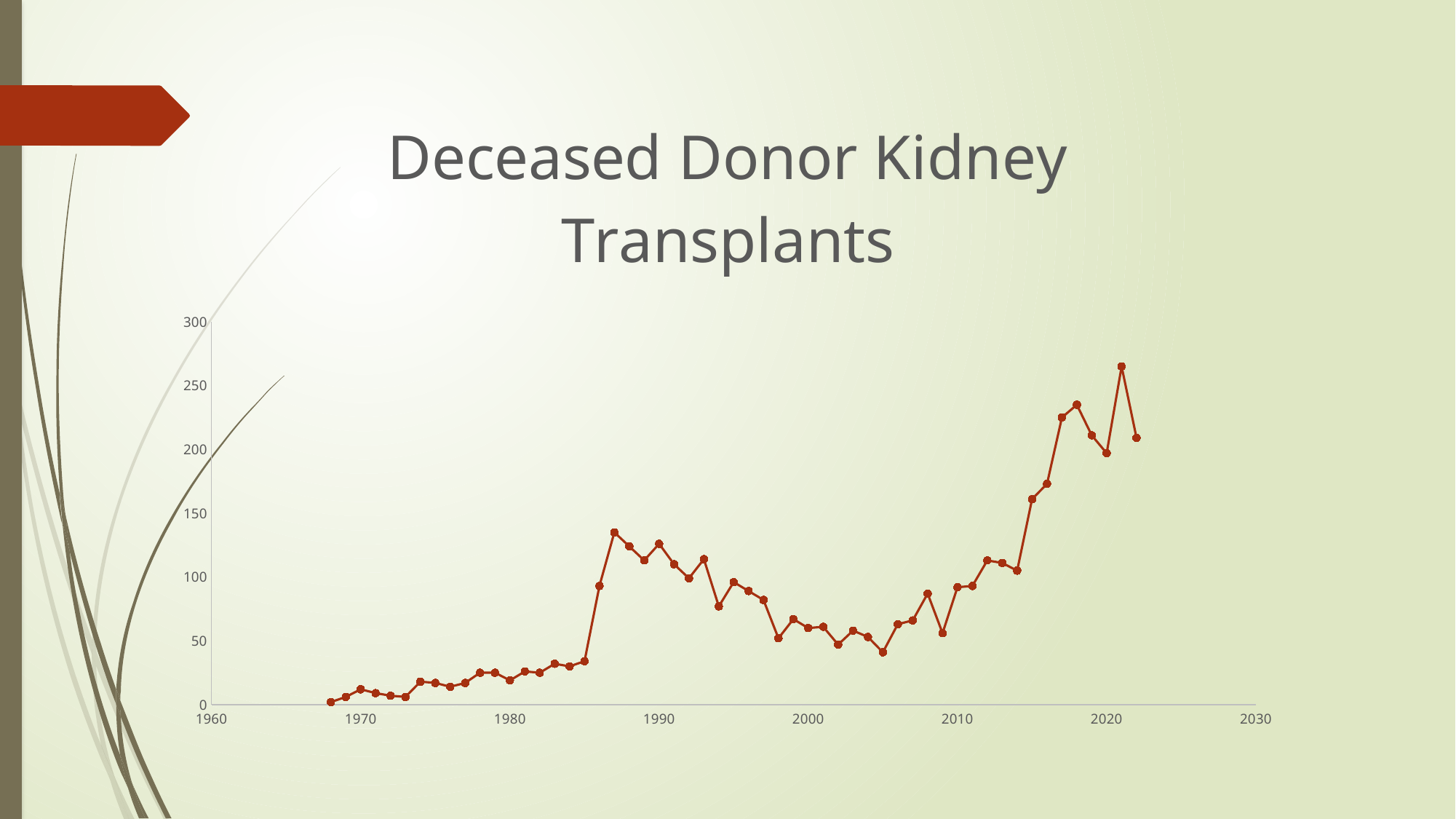
What is the title of the chart? Deceased Donor Kidney Transplants Is the value for 1980 greater or less than 50? less Which year has the larger value, 1990 or 2000? 1990 Do the values generally rise or fall between 2005 and 2021? rise In which year does the chart reach its highest value? 2021 Is the value for 2021 greater or less than 250? greater What kind of chart is shown on the slide? line chart Do the values generally rise or fall between 1987 and 2005? fall Is the value for 2017 greater or less than 200? greater In which year does the chart show its lowest value? 1968